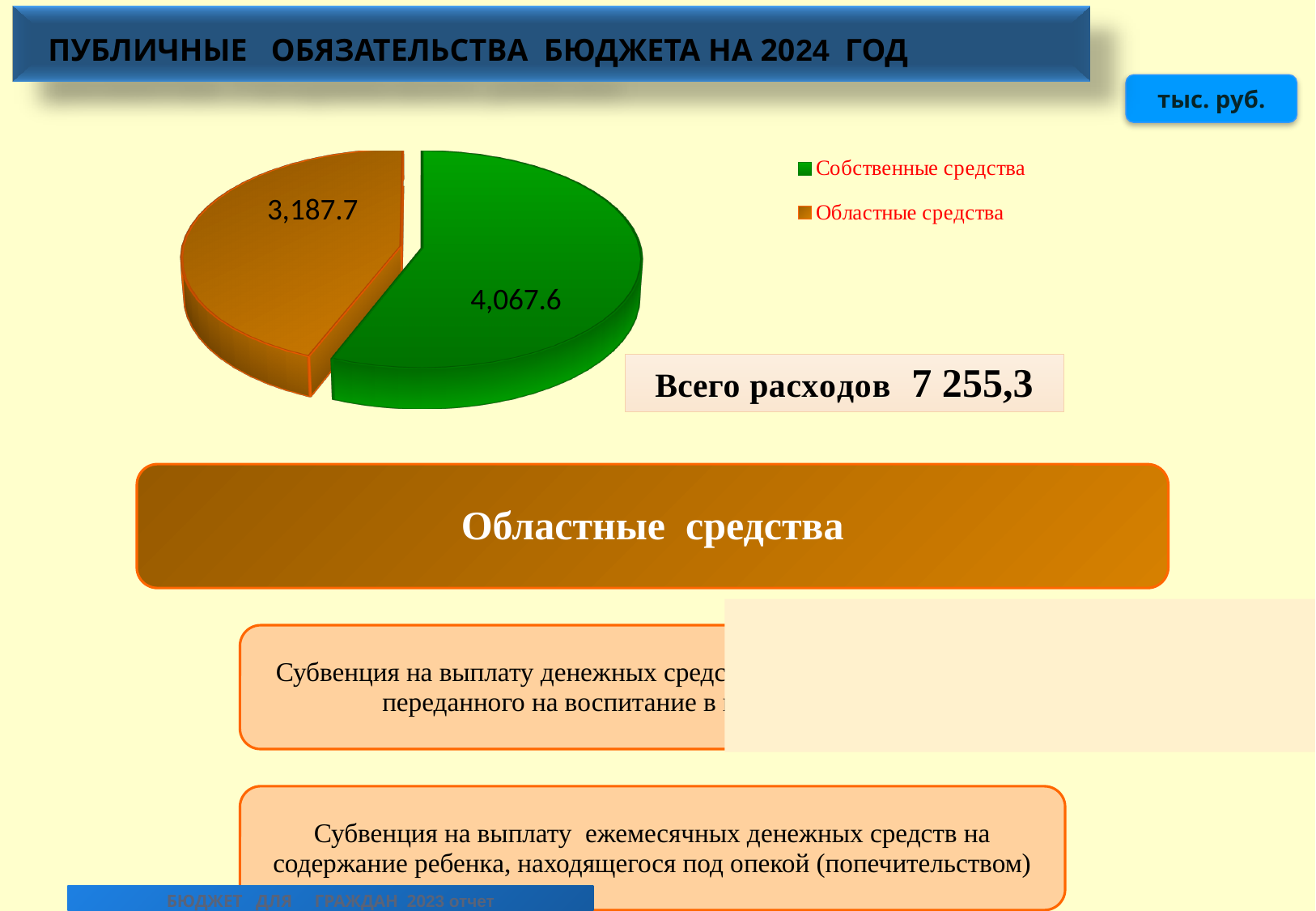
What total expenditure (Всего расходов) is shown next to the pie chart? 7 255,3 What is the difference between the values for Собственные средства and Областные средства? 879.9 What unit of measurement is indicated for the values on the slide? тыс. руб. What is the value for Областные средства in the pie chart? 3,187.7 What is the value for Собственные средства in the pie chart? 4,067.6 Which slice of the pie chart is the smallest? Областные средства Which is larger: Собственные средства or Областные средства? Собственные средства How many entries does the legend of the pie chart list? 2 What colour is the slice for Областные средства? orange How many slices does the pie chart have? 2 What kind of chart is shown on the slide? pie chart Which slice of the pie chart is the largest? Собственные средства